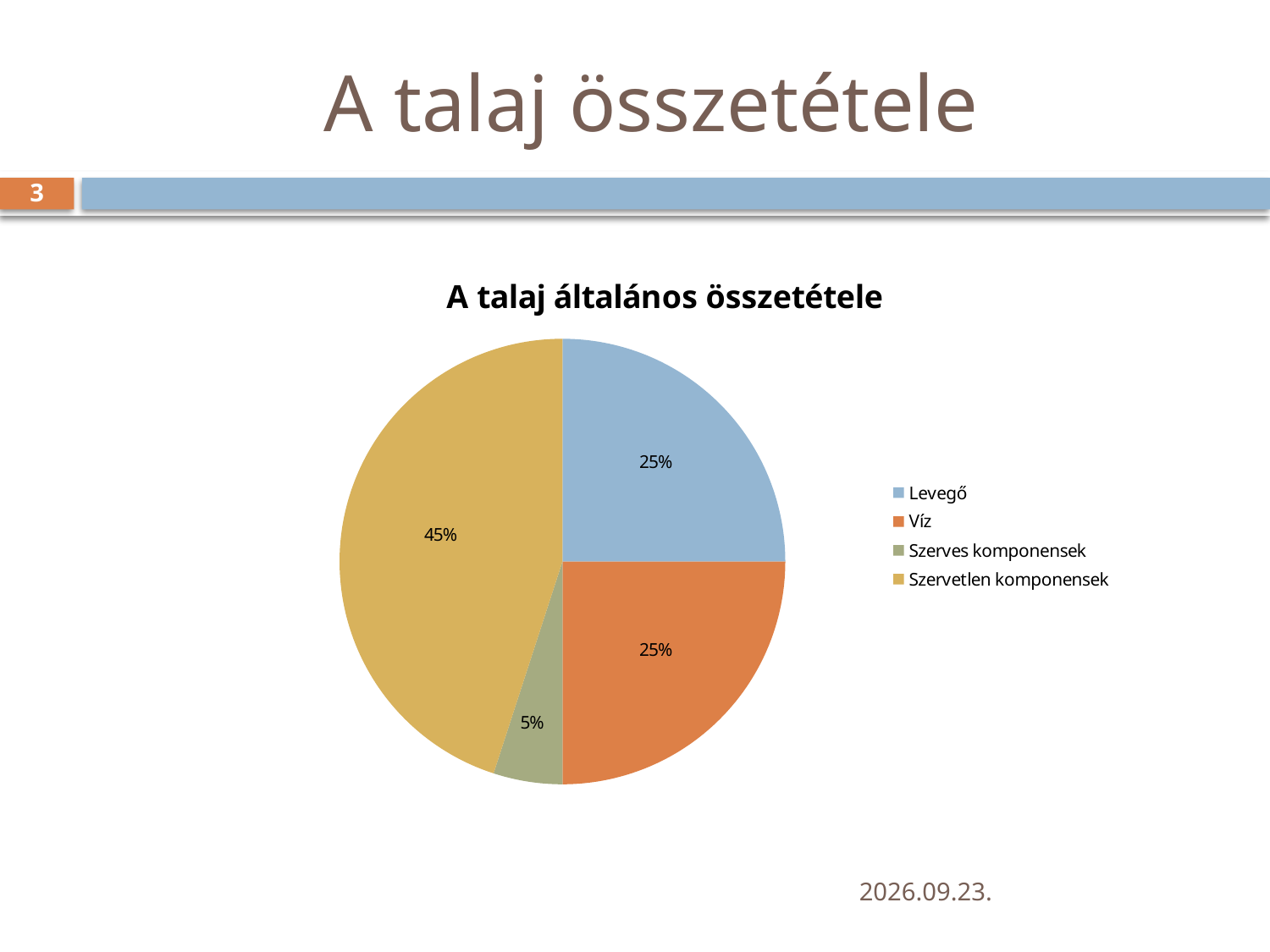
What is the value shown for Szerves komponensek? 5% What is the value shown for Víz? 25% What is the difference between the shares of Szervetlen komponensek and Szerves komponensek? 40% What is the title of the chart? A talaj általános összetétele Which is larger, the share for Víz or the share for Szerves komponensek? Víz How many categories does the legend list? 4 What share of the pie does Szervetlen komponensek take? 45% What colour is the slice for Szervetlen komponensek? yellow What is the value shown for Levegő? 25% Which category has the smallest slice of the pie? Szerves komponensek Which category has the largest slice of the pie? Szervetlen komponensek What kind of chart is shown on the slide? pie chart